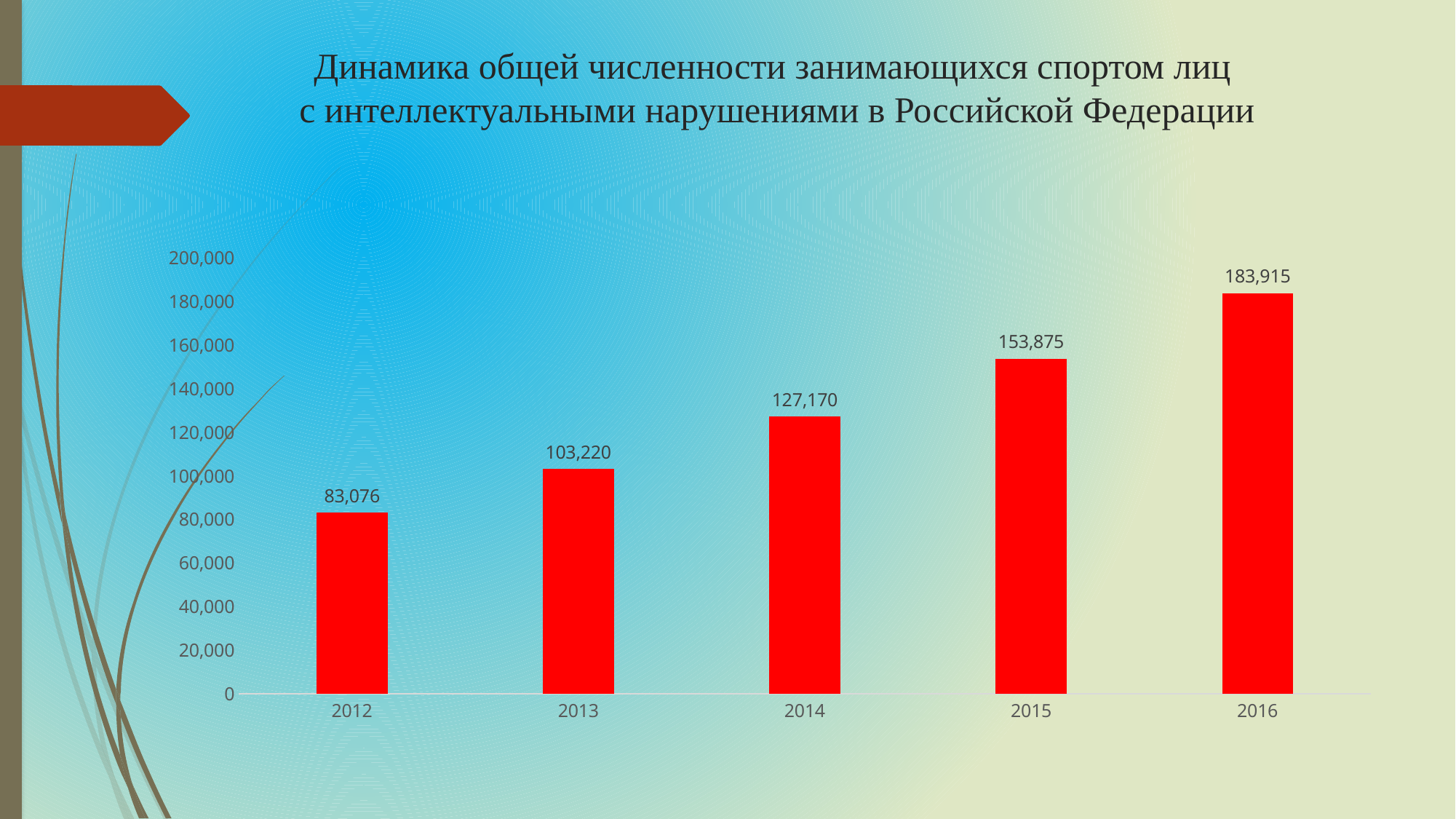
Do the values rise or fall from 2012 to 2016? rise Which year has the highest value? 2016 What is the value for 2014? 127,170 What kind of chart is shown on the slide? bar chart Is the value for 2015 greater or less than 140,000? greater What is the difference between the values for 2016 and 2015? 30,040 Which is larger, the value for 2014 or the value for 2013? 2014 What is the value for 2012? 83,076 How many years are shown on the x axis? 5 Which year has the lowest value? 2012 What is the value for 2016? 183,915 What is the difference between the values for 2013 and 2012? 20,144